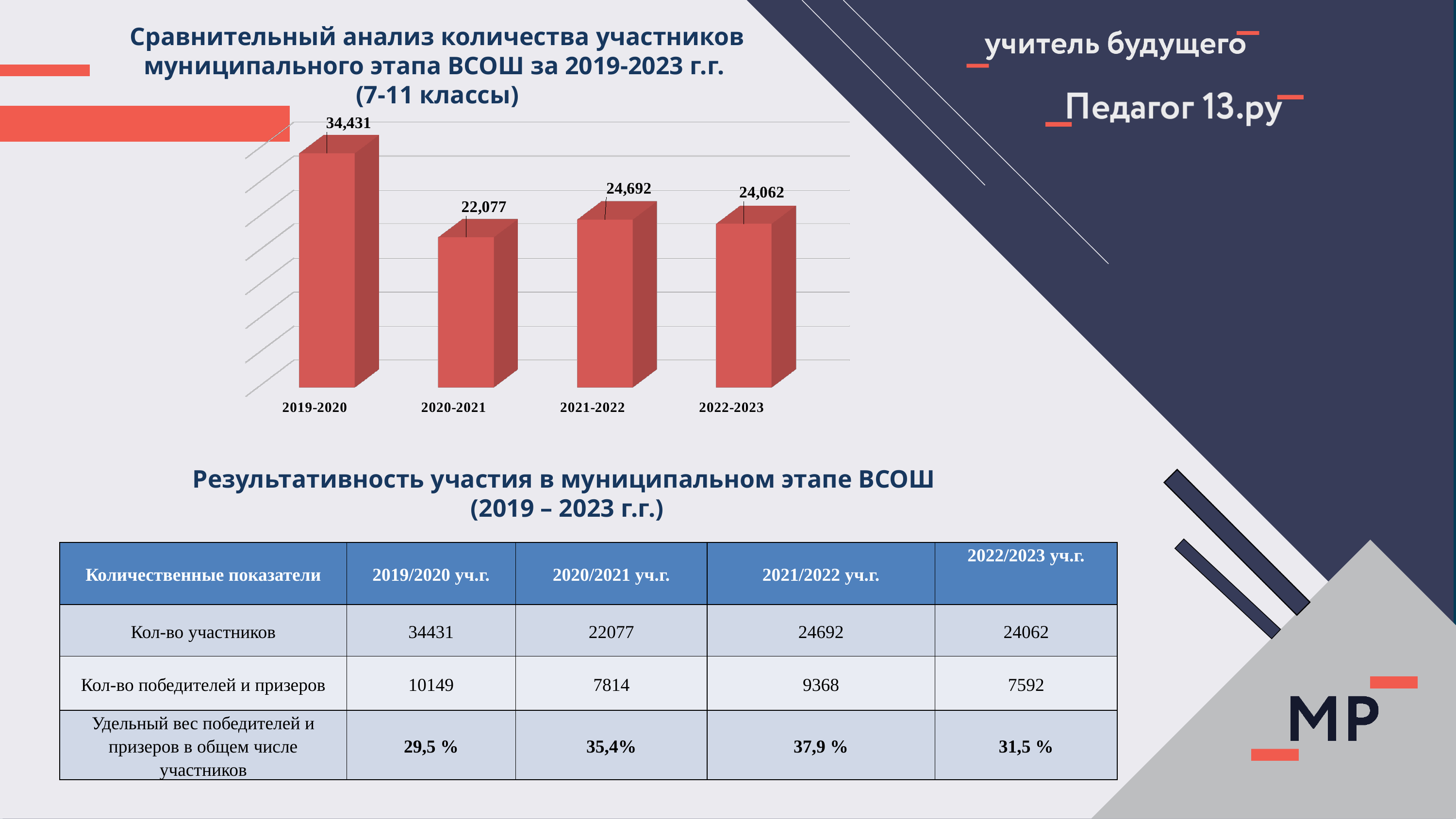
What is the difference in participants between 2021-2022 and 2022-2023? 630 How many academic years are shown on the chart? 4 What is the number of participants shown for 2019-2020? 34,431 What is the number of participants shown for 2020-2021? 22,077 Which year had more participants, 2021-2022 or 2020-2021? 2021-2022 What type of chart is used to show the number of participants? Bar chart What is the difference in participants between 2019-2020 and 2020-2021? 12,354 What is the number of participants shown for 2022-2023? 24,062 Did the number of participants rise or fall from 2019-2020 to 2020-2021? Fall What is the number of participants shown for 2021-2022? 24,692 Which academic year has the highest number of participants? 2019-2020 Which academic year has the lowest number of participants? 2020-2021